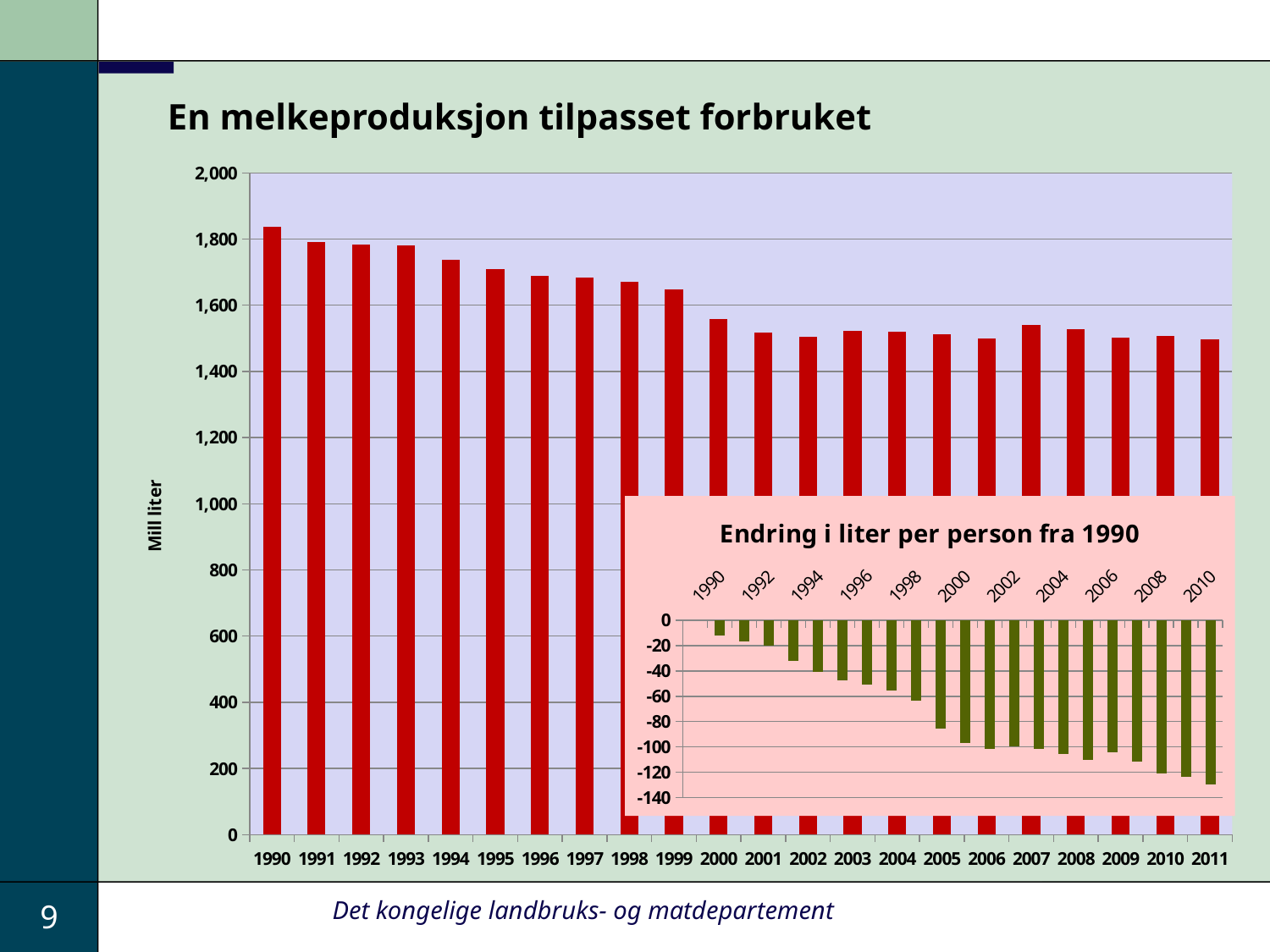
In the large chart, how many years are shown on the x axis? 22 In the inset chart 'Endring i liter per person fra 1990', is the value for 2010 greater or less than -100? less In the large chart, which year has the highest milk production? 1990 What is the y-axis label of the large chart? Mill liter In the large chart, do the values generally rise or fall from 1990 to 2011? fall In the inset chart 'Endring i liter per person fra 1990', do the values rise or fall along the x axis from 1990 to 2010? fall In the large chart, is the value for 1990 greater or less than 1,800? greater In the large chart, is the value for 1995 greater or less than 1,600? greater What is the title of the inset chart? Endring i liter per person fra 1990 What type of chart is the large chart on the slide? bar chart In the large chart, which is larger, the value for 1999 or the value for 2000? 1999